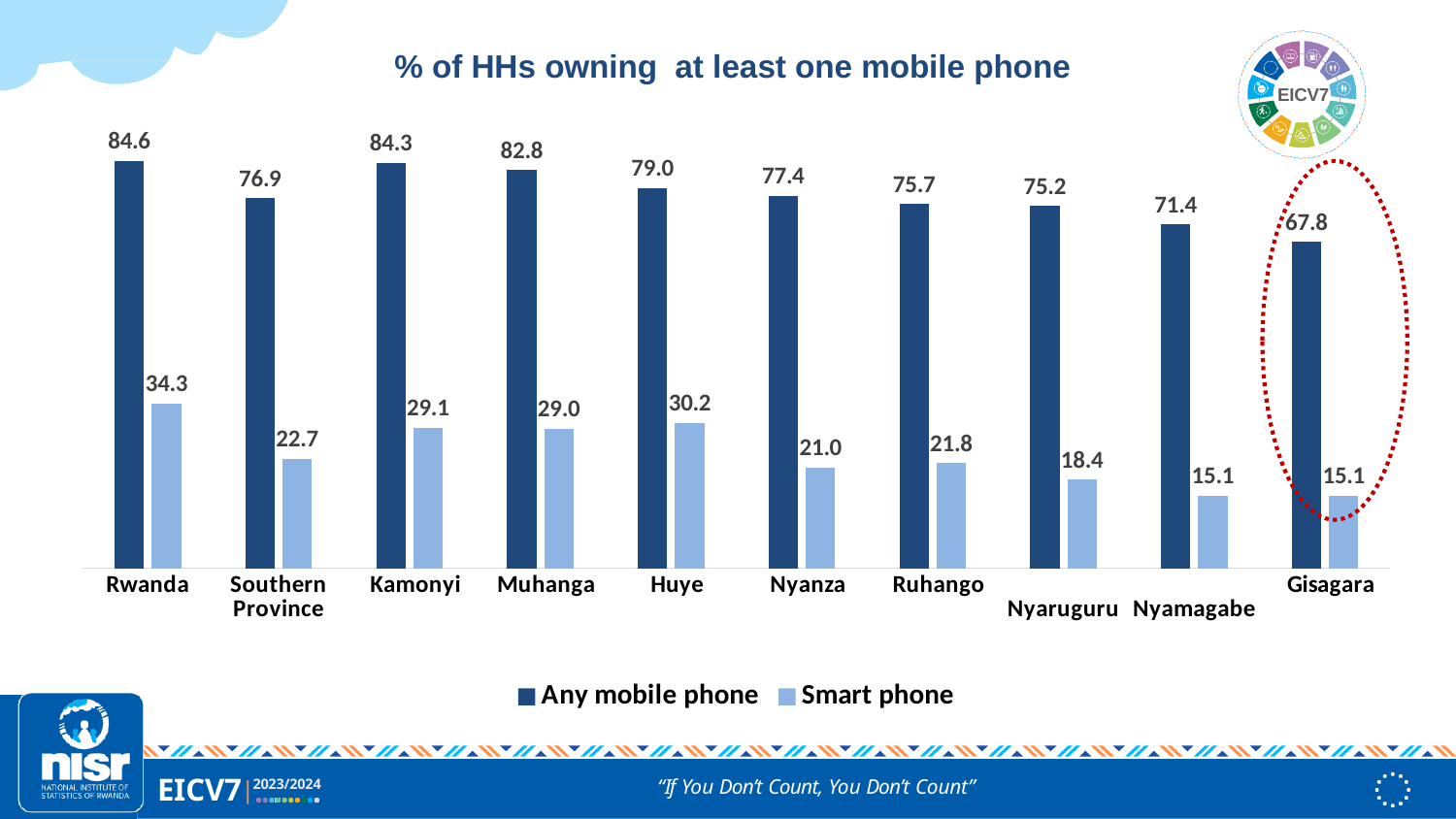
Which category has the lowest Any mobile phone value? Gisagara What kind of chart is shown on the slide? Bar chart What is the Any mobile phone value for Nyamagabe? 71.4 What is the difference between the Any mobile phone values for Huye and Nyanza? 1.6 What is the difference between the Any mobile phone and Smart phone values for Gisagara? 52.7 What is the Smart phone value for Huye? 30.2 What is the Smart phone value for Southern Province? 22.7 Which has a higher Smart phone value, Nyaruguru or Ruhango? Ruhango What percentage of households in Rwanda own any mobile phone? 84.6 Which category has the highest Smart phone value? Rwanda How many categories are shown on the x axis? 10 How many series does the legend list? 2